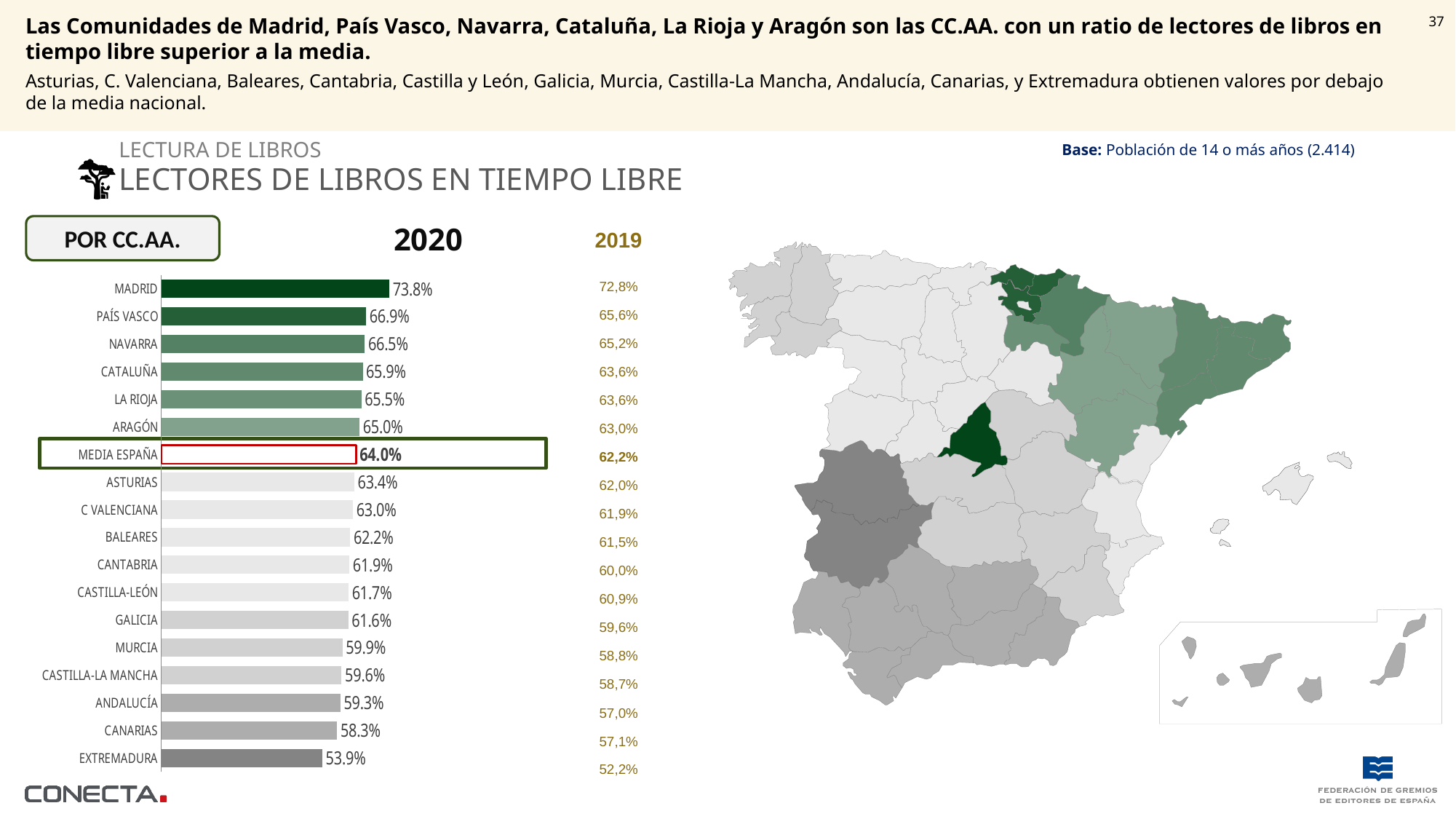
What is the 2019 value shown for Extremadura? 52,2% What kind of chart is used to show the 2020 values? Bar chart How many bars are shown in the chart, including Media España? 18 What is the difference between the 2020 value for Madrid and the Media España value? 9.8 percentage points What is the 2020 value for Media España? 64.0% Which has a higher 2020 value, Galicia or Murcia? Galicia Which two years of data are shown next to the bar chart? 2020 and 2019 Which community has the lowest 2020 value? Extremadura What is the 2020 value for Madrid? 73.8% Which community has the highest 2020 value? Madrid Do the 2020 values rise or fall going from the top bar to the bottom bar? Fall What is the difference between the 2020 values for Madrid and Extremadura? 19.9 percentage points